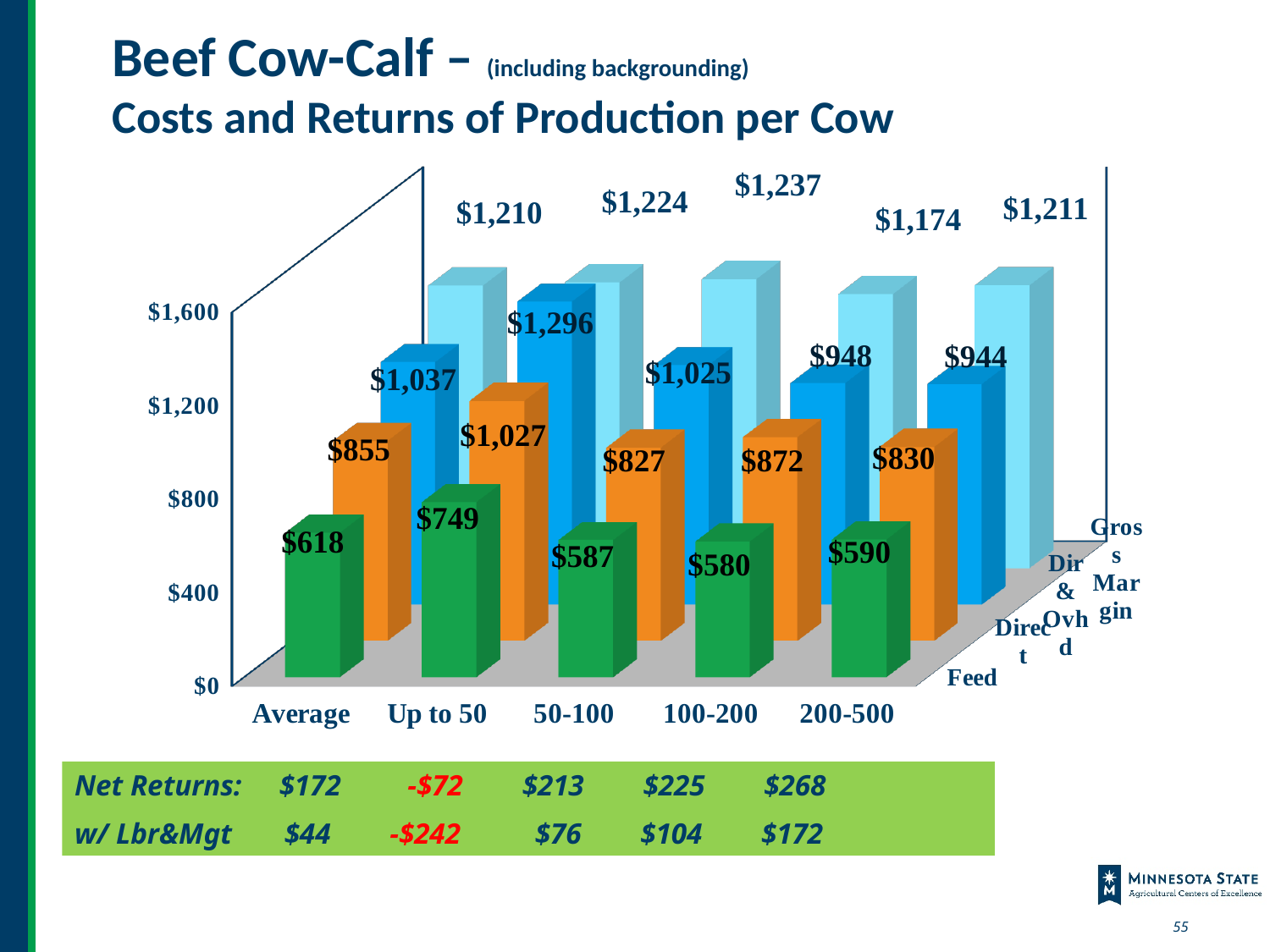
What is the Dir & Ovhd value for the 200-500 category? $944 What is the Gross Margin value for the 50-100 herd size category? $1,237 Is the Direct cost value larger for 100-200 or for 200-500? 100-200 How many data series are plotted in the chart? 4 What kind of chart is shown on the slide? Bar chart Which category has the highest Feed value? Up to 50 Which category has the lowest Gross Margin value? 100-200 What is the Net Returns value listed below the chart for the Up to 50 category? -$72 What is the Direct cost value for the Up to 50 category? $1,027 What is the Feed value for the Average category? $618 What is the difference between the Dir & Ovhd value for Up to 50 and for Average? $259 How many herd size categories are shown on the x axis? 5